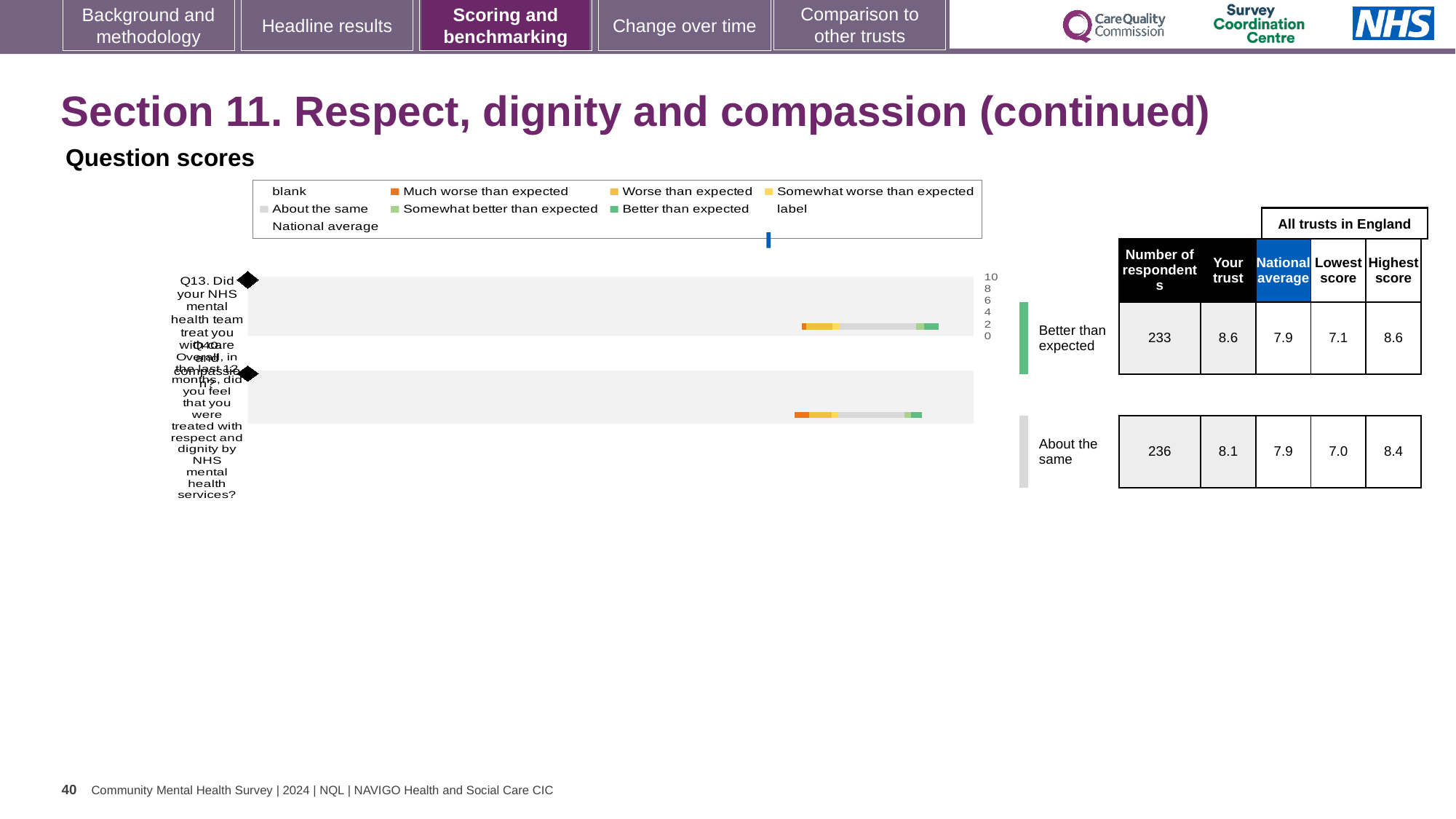
How many questions are plotted in the question scores chart? 2 What is the national average score for Q13? 7.9 What is the 'Your trust' score for Q14? 8.1 What kind of chart is used to show the question scores on this slide? bar chart What is the difference between the 'Your trust' score and the national average for Q13? 0.7 What is the highest score among all trusts in England for Q13? 8.6 What is the 'Your trust' score for Q13? 8.6 What is the lowest score among all trusts in England for Q14? 7.0 Which benchmark category is shown for Q13 (treated with care and compassion)? Better than expected Which benchmark category is shown for Q14 (treated with respect and dignity)? About the same Which question has the higher 'Your trust' score, Q13 or Q14? Q13 How many respondents answered Q14? 236